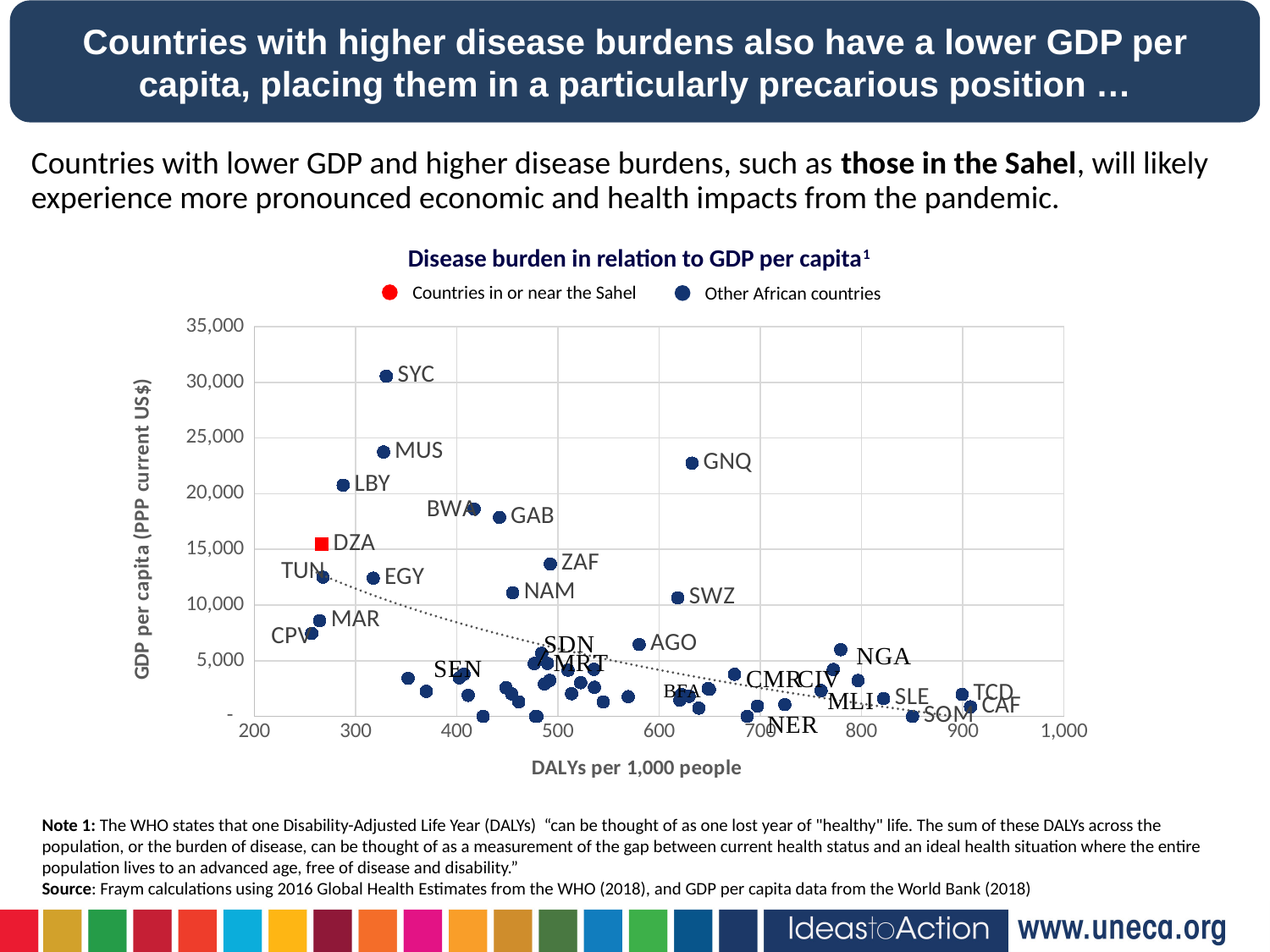
How many series does the legend list? 2 Is the DALYs per 1,000 people value for SOM greater or less than 800? greater Is the GDP per capita for SYC greater or less than 25,000? greater Which has the higher GDP per capita, GNQ or SWZ? GNQ As DALYs per 1,000 people increase along the x axis, does GDP per capita generally rise or fall? fall Is the GDP per capita for GAB greater or less than 20,000? less What kind of chart is shown on the slide? Scatter chart Which country has the highest GDP per capita in the chart? SYC Which legend series is shown with a red marker? Countries in or near the Sahel